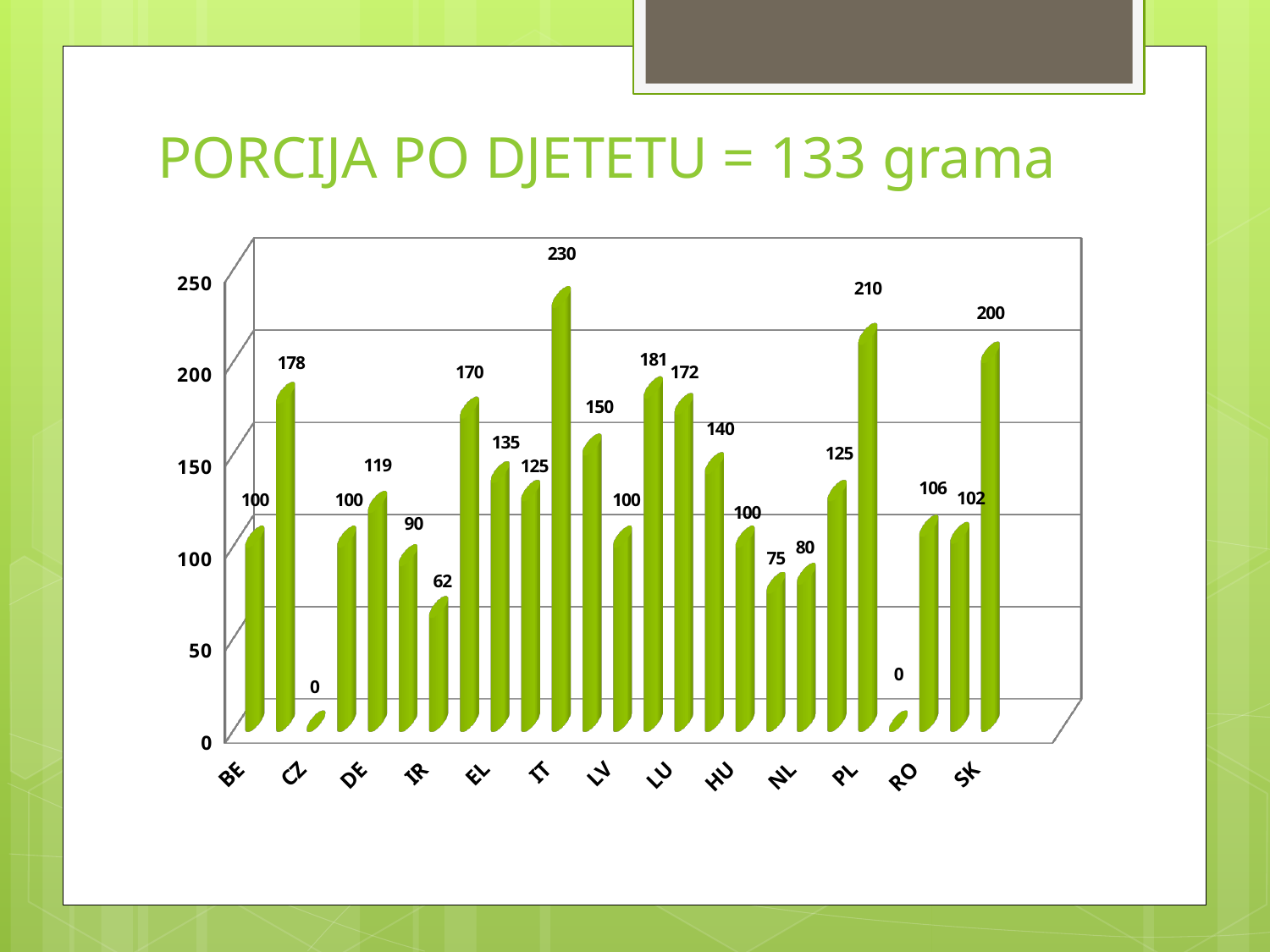
How many bars are plotted in the chart? 25 Which is larger, the value for IT or the value for SK? IT What is the value for SK? 200 What is the lowest value shown in the chart? 0 What is the value for BE? 100 What is the value for PL? 210 What is the highest value shown in the chart? 230 Is the value for IR greater or less than 100? less What kind of chart is shown on the slide? bar chart What is the difference between the highest value (230) and the value for PL (210)? 20 What is the title of the chart on the slide? PORCIJA PO DJETETU = 133 grama What is the value for IT? 230